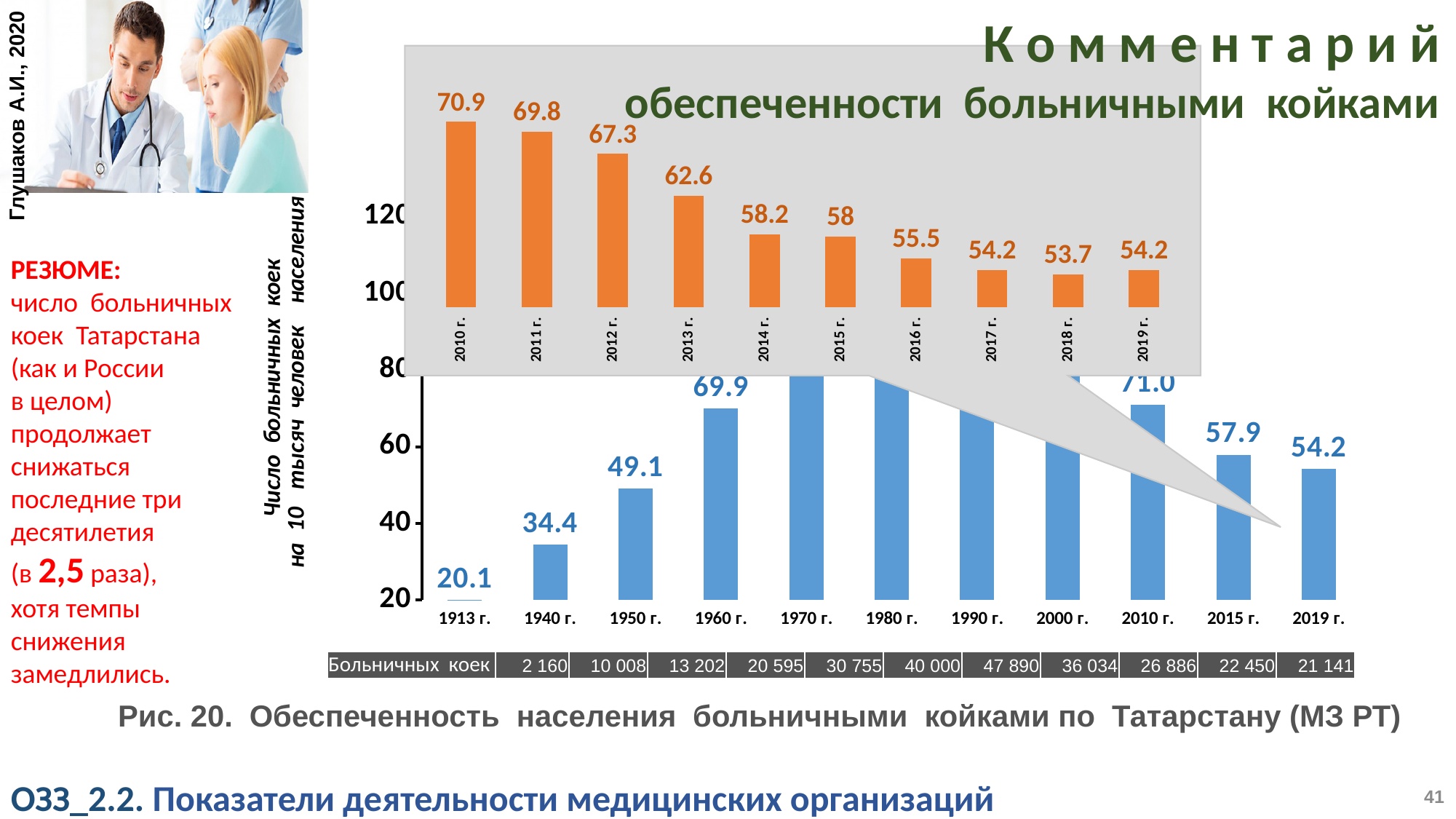
In the main blue chart, is the value for 1990 г. greater or less than 60? greater In the inset chart (2010–2019), which year has the lowest value? 2018 г. In the main blue chart, what is the value for 2015 г.? 57.9 In the inset chart (2010–2019), how many years are plotted? 10 In the main blue chart, which is larger, the value for 1960 г. or the value for 2010 г.? 2010 г. What type of chart is the main chart on the slide? bar chart In the inset chart (2010–2019), what is the value for 2013? 62.6 In the main blue chart, how many hospital beds (Больничных коек) are listed in the data table for 1990 г.? 47 890 In the inset chart (2010–2019), what is the difference between the values for 2010 and 2019? 16.7 In the main blue chart, what is the value for 1950 г.? 49.1 In the inset chart (2010–2019), which year has the highest value? 2010 г. In the inset chart (2010–2019), do the values generally rise or fall from 2010 to 2019? fall